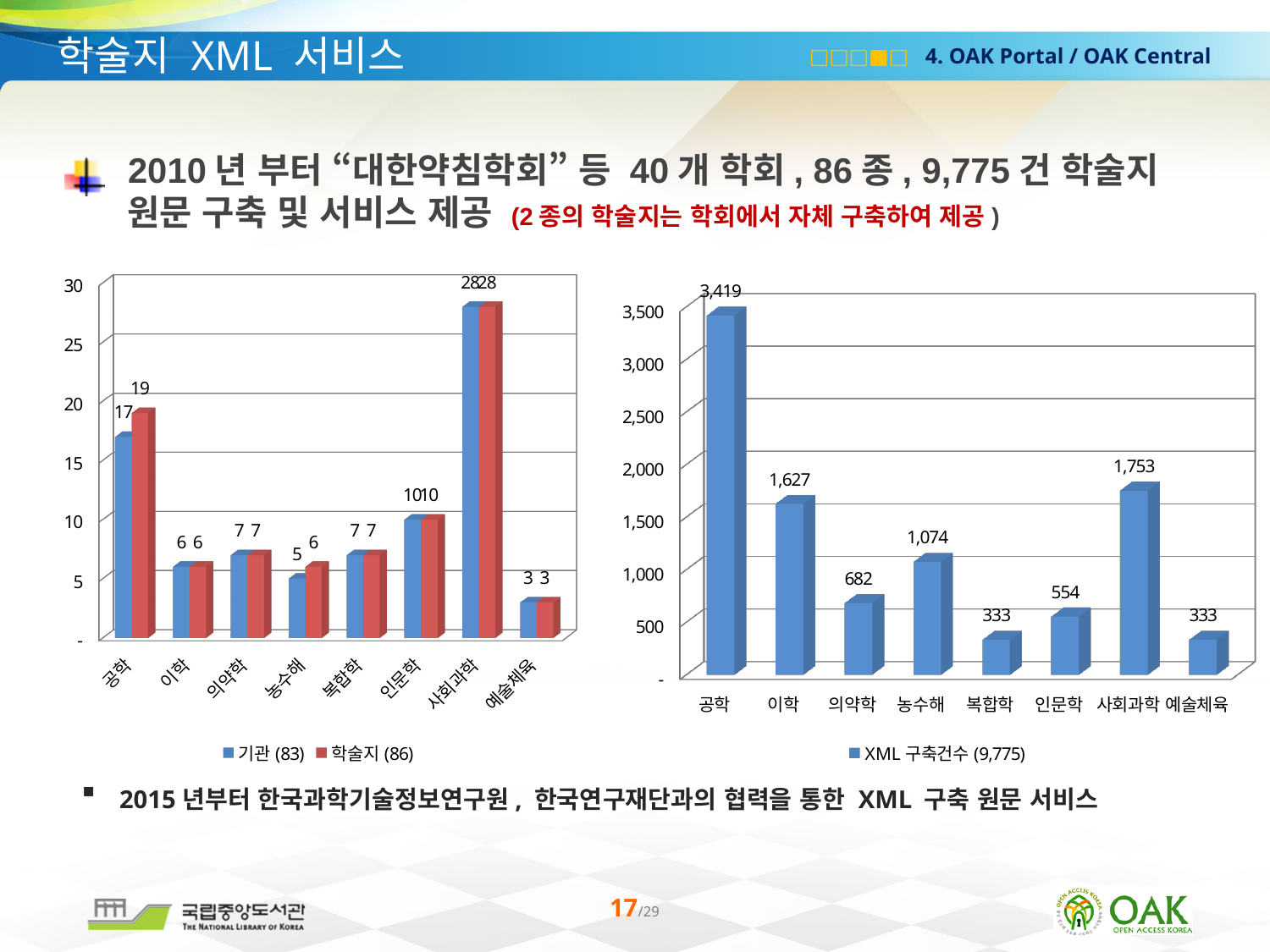
In the left chart, what is the value of 기관 (83) for 공학? 17 How many categories are shown on the x axis of the right chart? 8 In the right chart, what is the XML 구축건수 value for 이학? 1,627 How many series does the legend of the left chart list? 2 In the left chart, which category has the lowest value for 기관 (83)? 예술체육 In the left chart, what is the difference between the 학술지 (86) and 기관 (83) values for 공학? 2 In the right chart, which is larger, the value for 농수해 or the value for 의약학? 농수해 In the left chart, what is the value of 학술지 (86) for 농수해? 6 In the right chart, which category has the highest XML 구축건수 value? 공학 In the left chart, which category has the highest value for 학술지 (86)? 사회과학 In the right chart, what is the difference between the values for 공학 and 사회과학? 1,666 In the right chart, what is the XML 구축건수 value for 인문학? 554